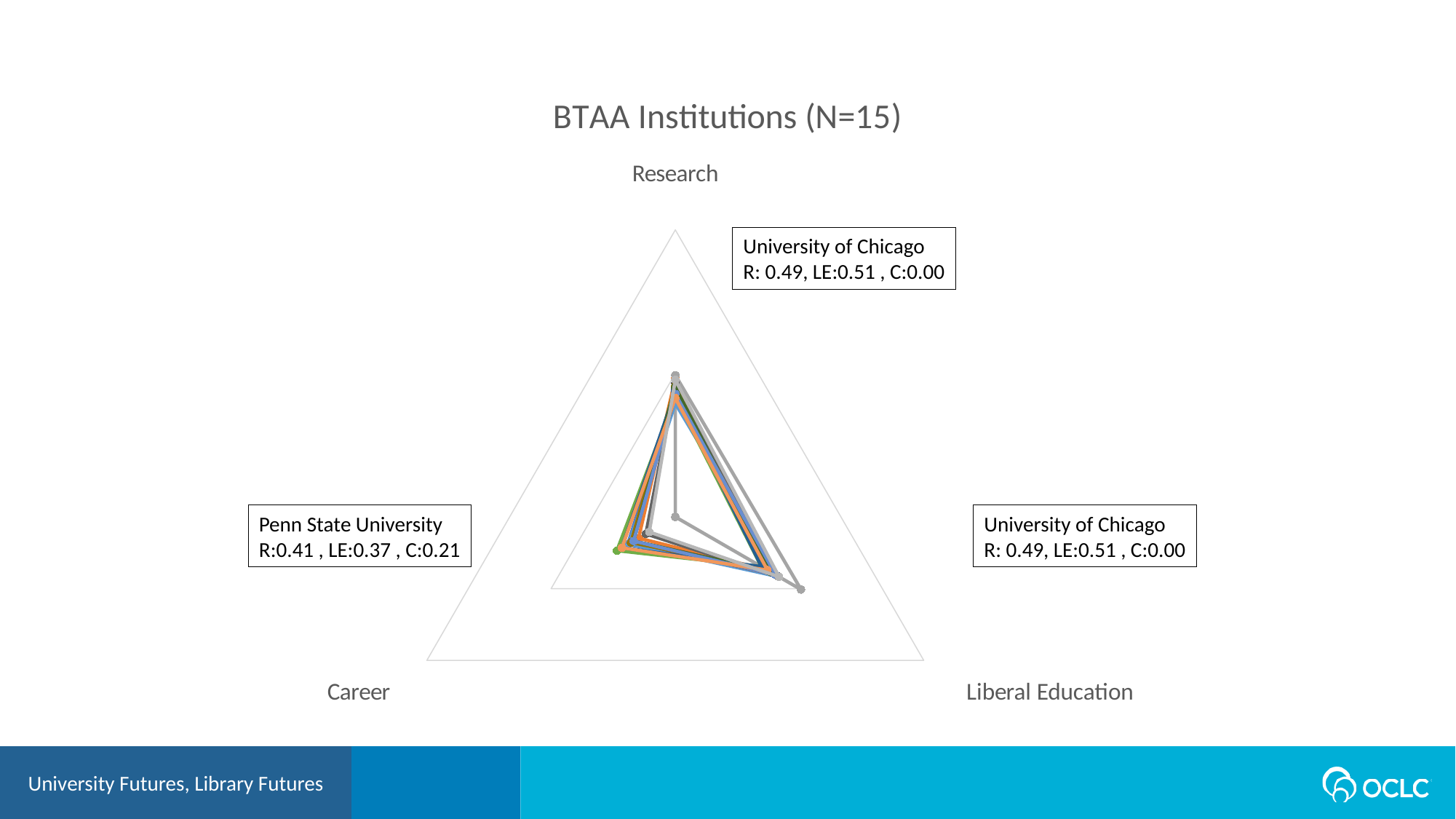
What is the Research (R) value for University of Chicago? 0.49 What is the difference between the Research values of University of Chicago and Penn State University? 0.08 How many axes (dimensions) does the radar chart have? 3 What is the Liberal Education (LE) value for University of Chicago? 0.51 What are the three axis labels on the radar chart? Research, Career, Liberal Education What kind of chart is shown on the slide? Radar chart Which dimension has the highest value for Penn State University? Research What is the Career (C) value for University of Chicago? 0.00 What is the Career (C) value for Penn State University? 0.21 Which is larger for Penn State University, the Research value or the Liberal Education value? Research What is the title of the chart? BTAA Institutions (N=15) Which dimension has the lowest value for University of Chicago? Career